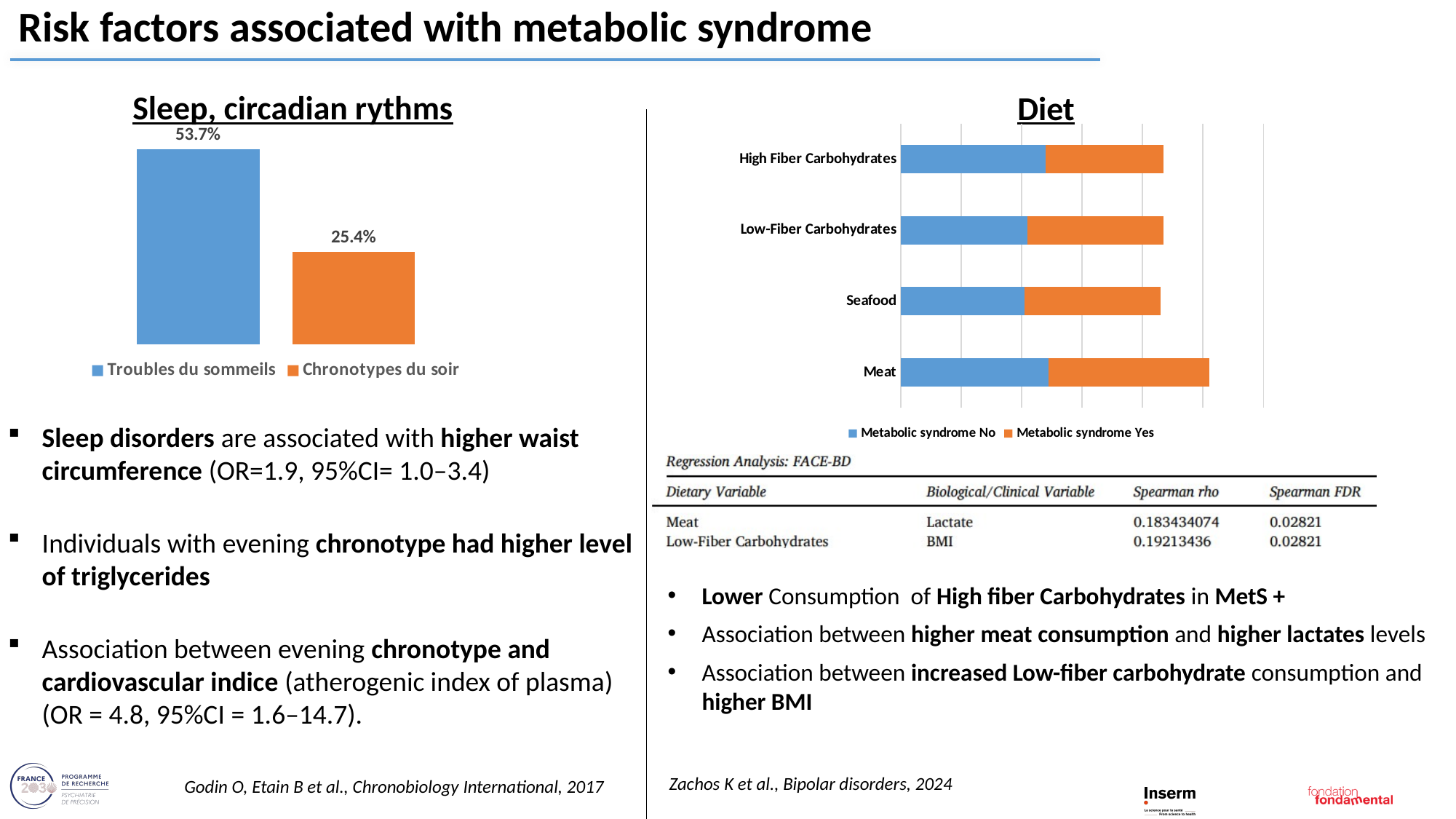
On the Sleep, circadian rythms chart, how many bars are plotted? 2 On the Sleep, circadian rythms chart, what is the value for Troubles du sommeils? 53.7% What kind of chart is the Sleep, circadian rythms chart? Bar chart On the Sleep, circadian rythms chart, what is the difference between Troubles du sommeils and Chronotypes du soir? 28.3% On the Diet chart, which series is shown in orange? Metabolic syndrome Yes On the Sleep, circadian rythms chart, which category has the lower value? Chronotypes du soir On the Sleep, circadian rythms chart, which category has the higher value? Troubles du sommeils On the Diet chart, how many food categories are listed? 4 On the Diet chart, how many series does the legend list? 2 On the Sleep, circadian rythms chart, what is the value for Chronotypes du soir? 25.4% On the Diet chart, which category has the longest total bar? Meat What kind of chart is the Diet chart? Stacked bar chart